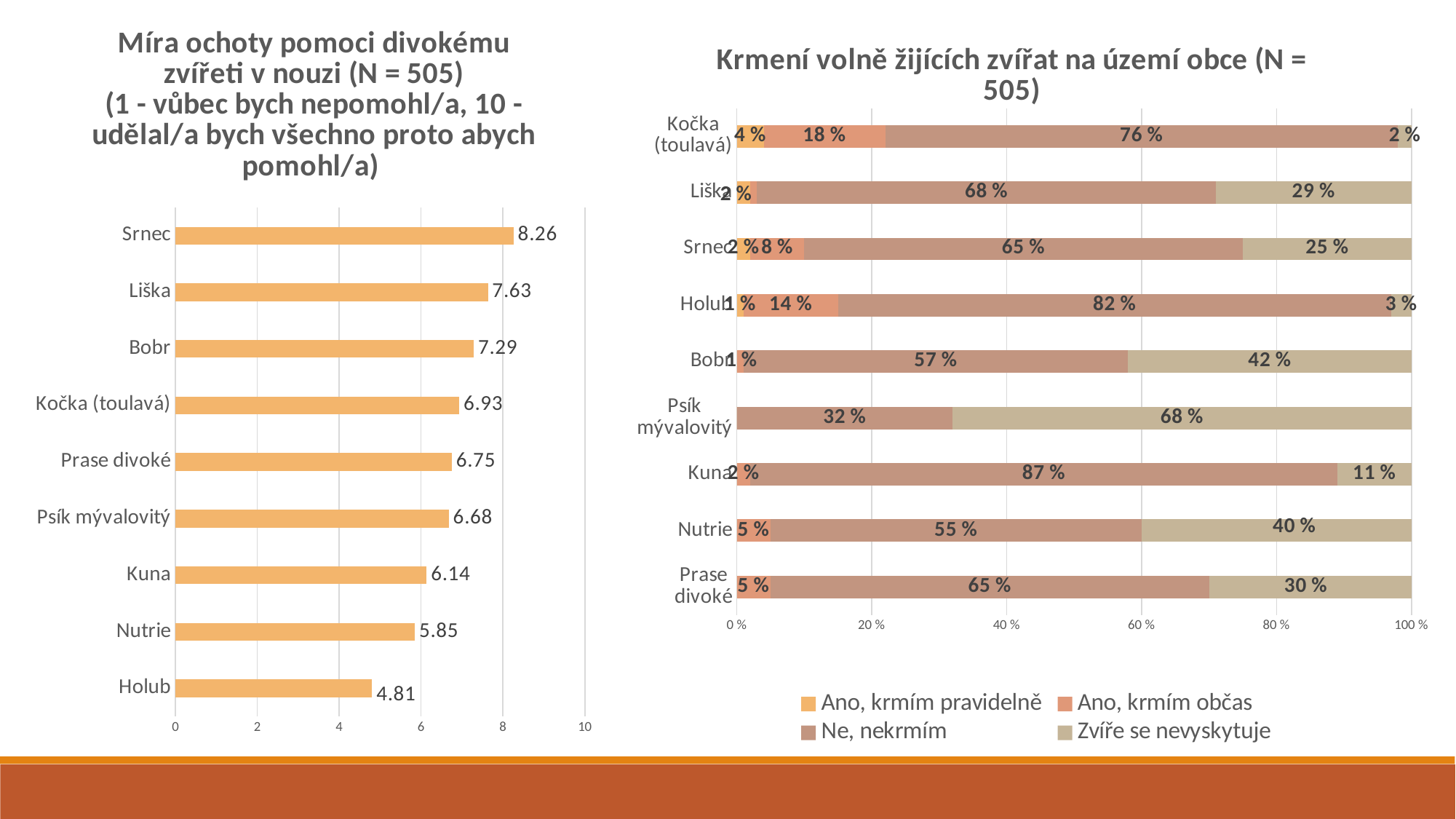
In the left chart (Míra ochoty pomoci divokému zvířeti v nouzi), which is larger: the value for Kuna or the value for Psík mývalovitý? Psík mývalovitý In the left chart (Míra ochoty pomoci divokému zvířeti v nouzi), which category has the lowest value? Holub In the left chart (Míra ochoty pomoci divokému zvířeti v nouzi), what is the value for Nutrie? 5.85 What type of chart is the right chart (Krmení volně žijících zvířat na území obce)? Stacked bar chart In the right chart (Krmení volně žijících zvířat na území obce), which category has the highest 'Zvíře se nevyskytuje' share? Psík mývalovitý In the left chart (Míra ochoty pomoci divokému zvířeti v nouzi), what is the value for Srnec? 8.26 In the left chart (Míra ochoty pomoci divokému zvířeti v nouzi), which category has the highest value? Srnec In the left chart (Míra ochoty pomoci divokému zvířeti v nouzi), how many categories are shown? 9 In the left chart (Míra ochoty pomoci divokému zvířeti v nouzi), what is the difference between the values for Liška and Bobr? 0.34 In the right chart (Krmení volně žijících zvířat na území obce), how many series does the legend list? 4 In the right chart (Krmení volně žijících zvířat na území obce), what is the 'Zvíře se nevyskytuje' share for Psík mývalovitý? 68 % In the right chart (Krmení volně žijících zvířat na území obce), what is the 'Ne, nekrmím' share for Kuna? 87 %